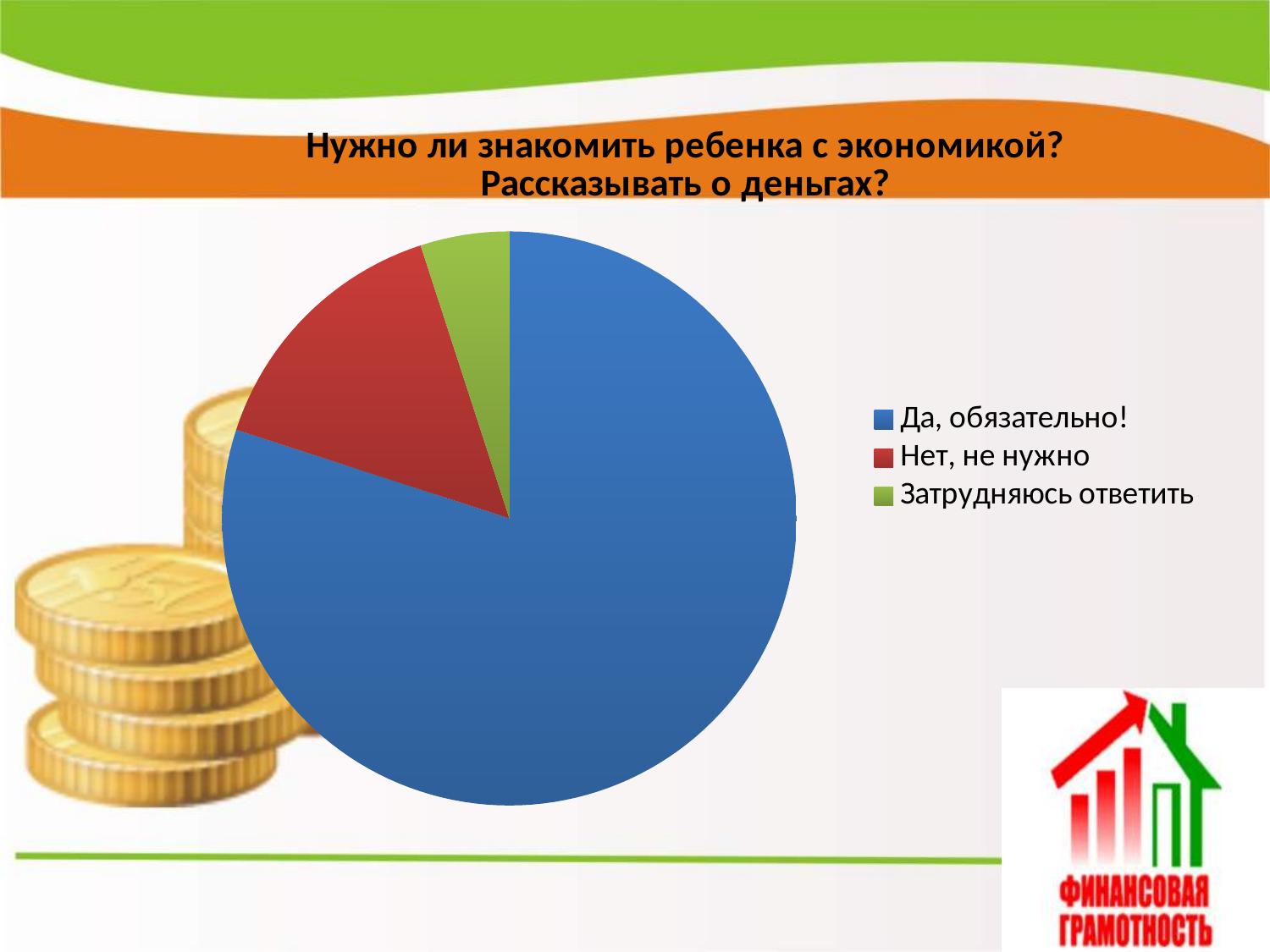
Which slice is larger: "Нет, не нужно" or "Затрудняюсь ответить"? Нет, не нужно What kind of chart is shown on the slide? Pie chart What is the title of the chart on the slide? Нужно ли знакомить ребенка с экономикой? Рассказывать о деньгах? How many slices does the pie chart have? 3 What colour is the slice for "Нет, не нужно" in the pie chart? Red Which slice is larger: "Да, обязательно!" or "Нет, не нужно"? Да, обязательно! Which category has the smallest slice of the pie chart? Затрудняюсь ответить How many entries does the legend of the pie chart list? 3 Which category has the largest slice of the pie chart? Да, обязательно!